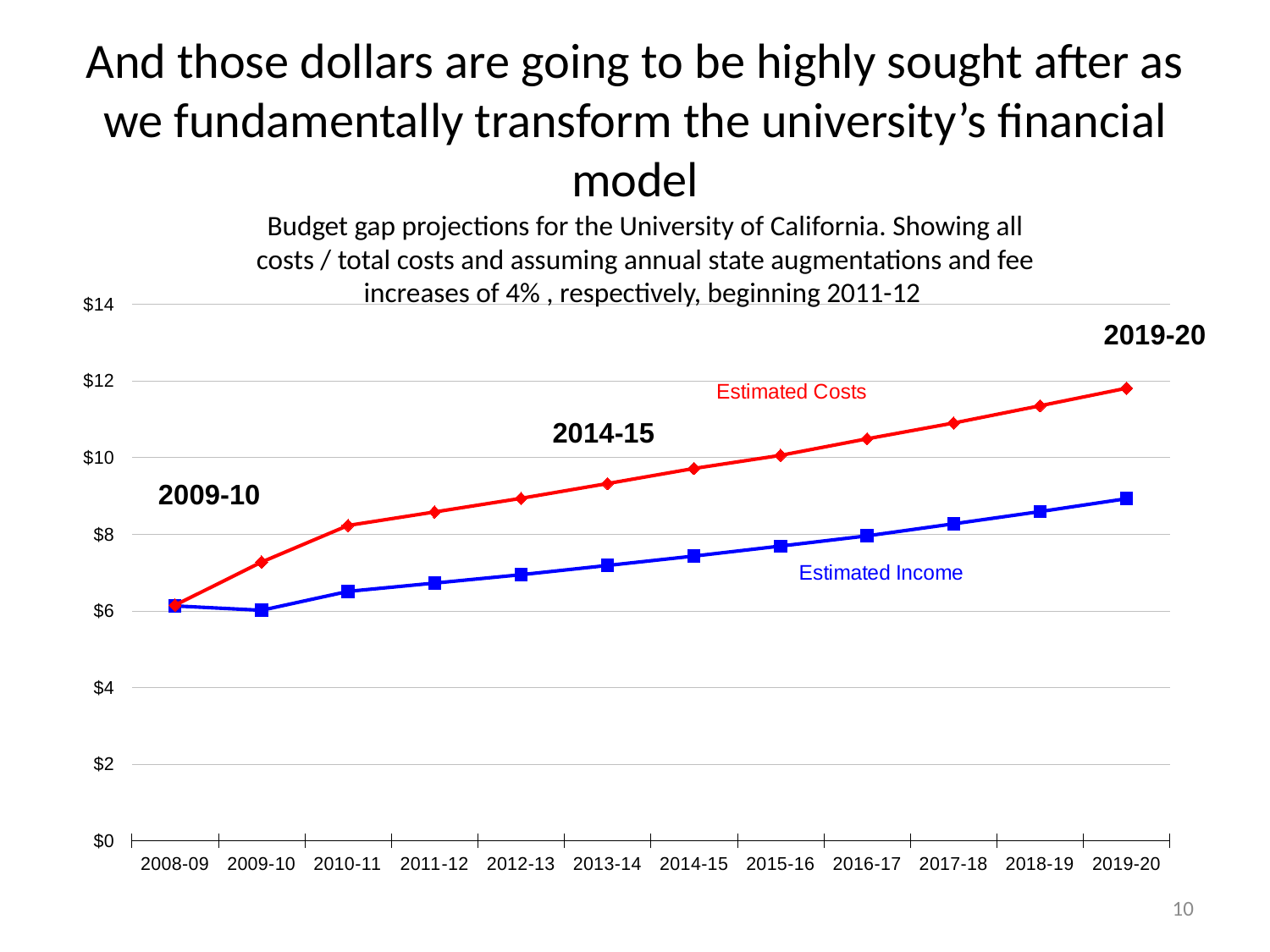
How many academic years are shown along the x axis? 12 What kind of chart is shown on the slide? line chart Is the Estimated Income value for 2019-20 greater or less than $10? less In 2019-20, which is larger, Estimated Costs or Estimated Income? Estimated Costs Which series is shown in red? Estimated Costs How many series are plotted on the chart? 2 In which year is Estimated Costs at its lowest? 2008-09 Is the Estimated Costs value for 2019-20 greater or less than $10? greater Is the Estimated Costs value for 2019-20 greater or less than $12? less In which year is Estimated Costs at its highest? 2019-20